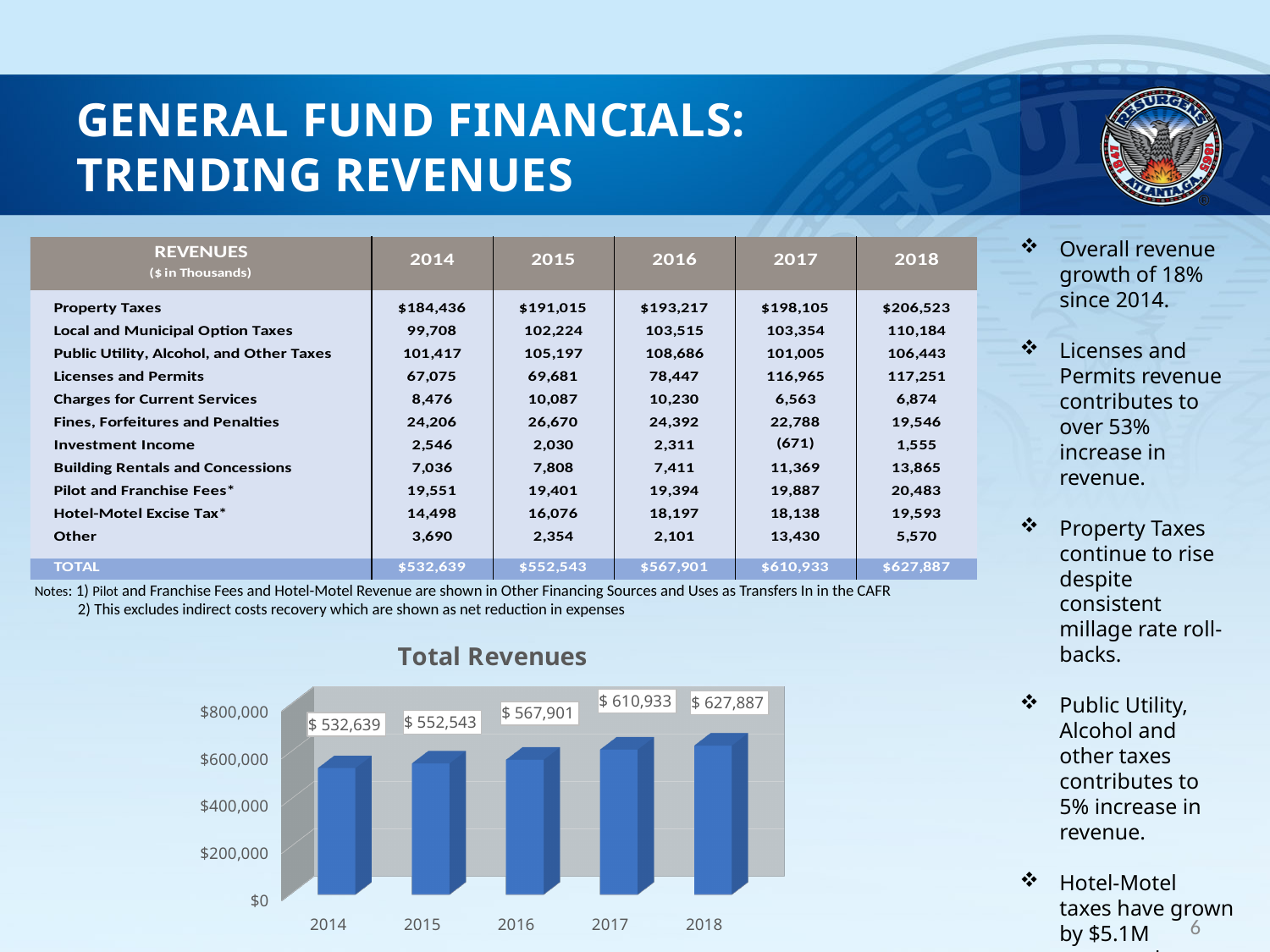
In the Total Revenues chart, is the value for 2017 greater or less than $600,000? greater In the Total Revenues chart, which year has the lowest total revenue? 2014 In the Total Revenues chart, what is the value for 2017? $ 610,933 In the Total Revenues chart, what is the value for 2014? $ 532,639 In the Total Revenues chart, which is larger, the value for 2015 or the value for 2016? 2016 In the Total Revenues chart, which year has the highest total revenue? 2018 In the Total Revenues chart, what is the difference between the 2017 and 2016 values? 43,032 In the Total Revenues chart, what is the difference between the 2018 and 2014 values? 95,248 What kind of chart is the Total Revenues chart? bar chart How many years are shown on the x axis of the Total Revenues chart? 5 In the Total Revenues chart, do the values rise or fall from 2014 to 2018? rise In the Total Revenues chart, what is the value for 2018? $ 627,887